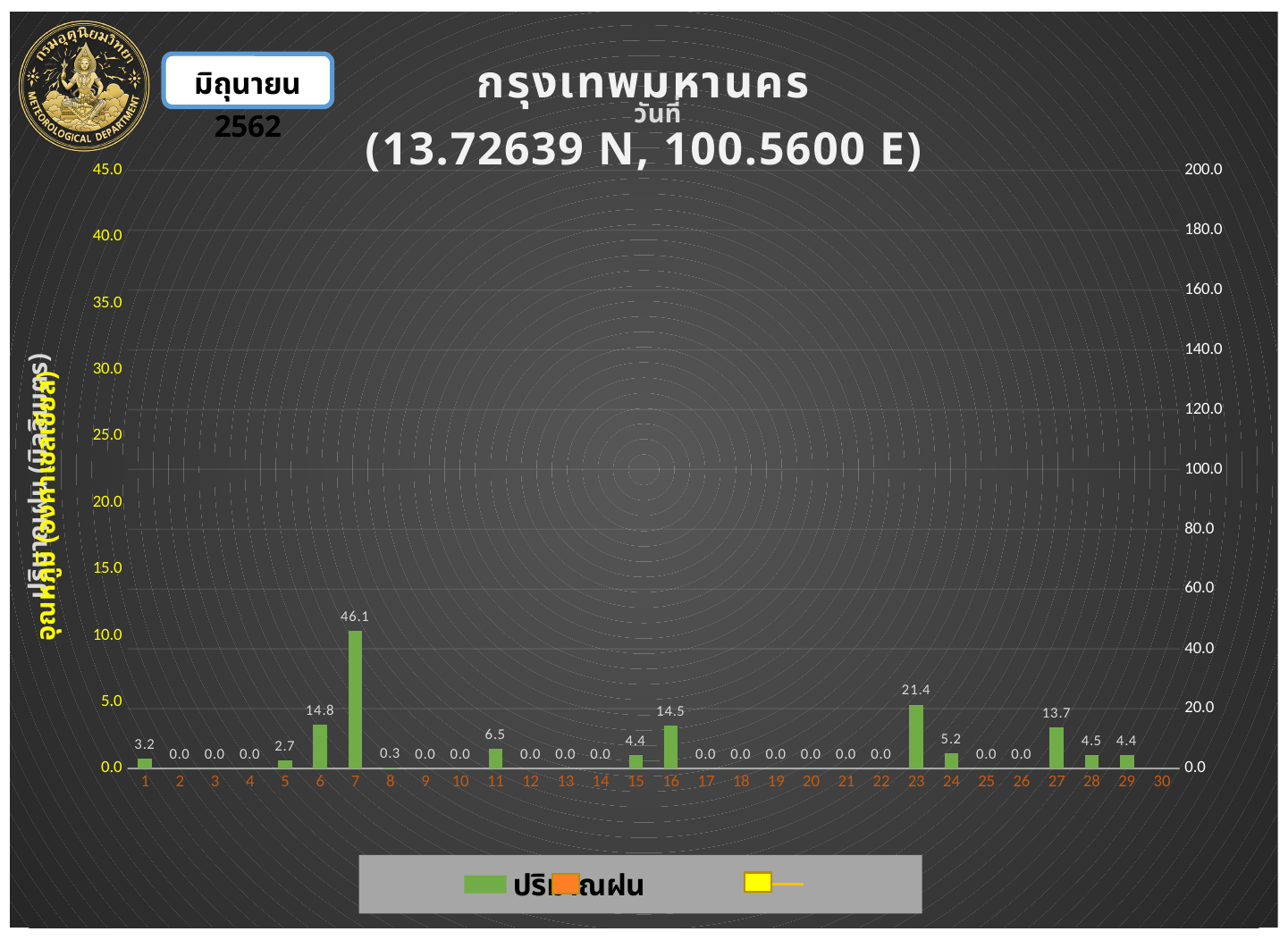
What is the rainfall value labelled for day 27? 13.7 What is the rainfall value labelled for day 23? 21.4 Which has a larger rainfall value, day 11 or day 24? day 11 What is the rainfall value labelled for day 7? 46.1 Is the rainfall value for day 7 greater or less than 40.0 on the right-hand axis? greater Which day has the highest rainfall value? 7 What is the rainfall value labelled for day 8? 0.3 How many days are shown on the x axis? 30 What is the difference between the rainfall values for day 7 and day 23? 24.7 What kind of chart is shown on the slide? bar chart What is the difference between the rainfall values for day 6 and day 16? 0.3 What is the rainfall value labelled for day 6? 14.8